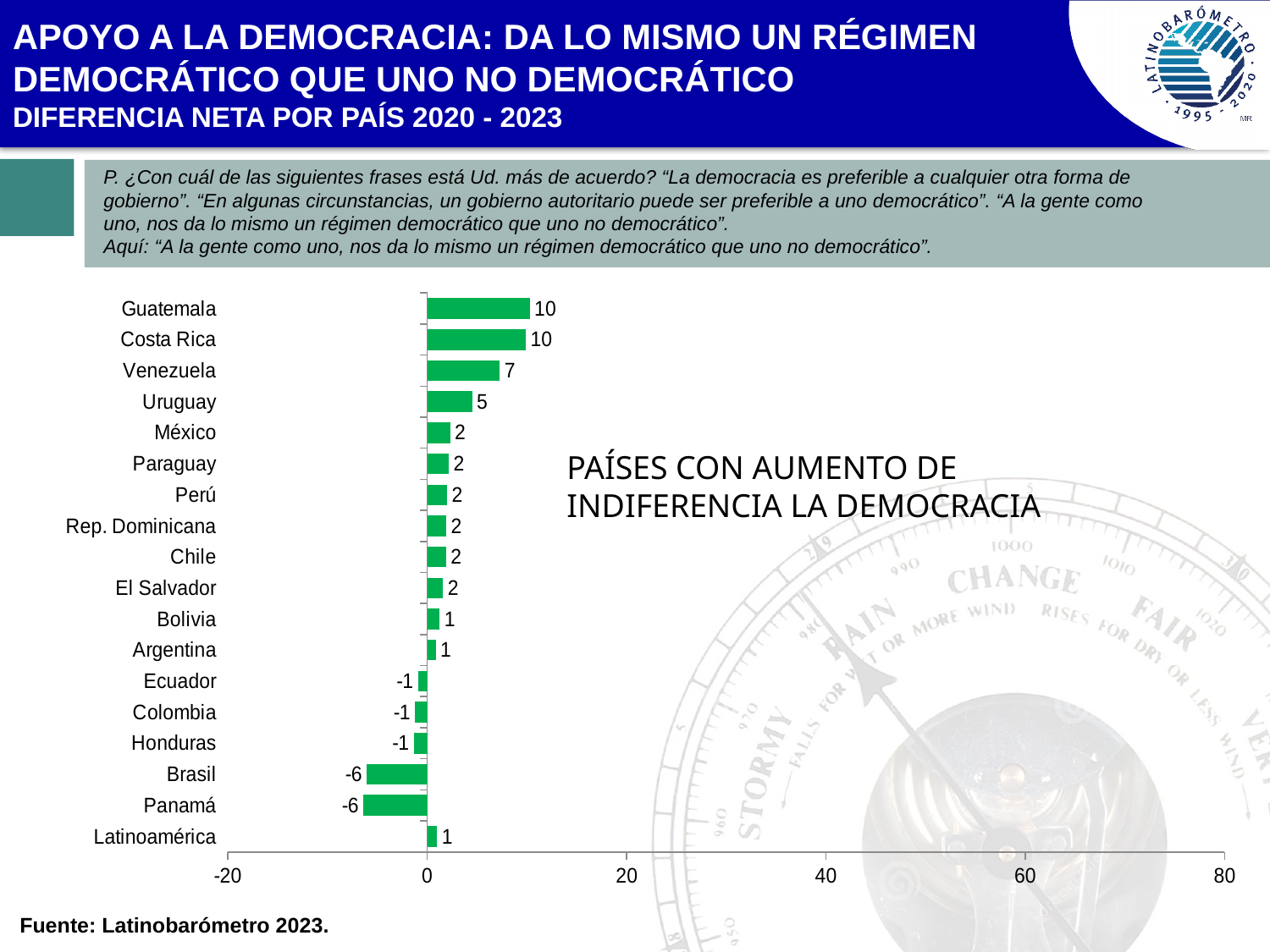
What is the value for Venezuela? 7 What kind of chart is shown on the slide? Bar chart What is the value for Latinoamérica? 1 Which two countries share the highest value? Guatemala and Costa Rica Which has a larger value, Venezuela or México? Venezuela How many categories are shown on the chart? 18 What is the difference between the values for Guatemala and Uruguay? 5 What is the value for Uruguay? 5 What is the value for Honduras? -1 Which two countries share the lowest value? Brasil and Panamá What is the source cited at the bottom of the slide? Latinobarómetro 2023 What is the value for Brasil? -6